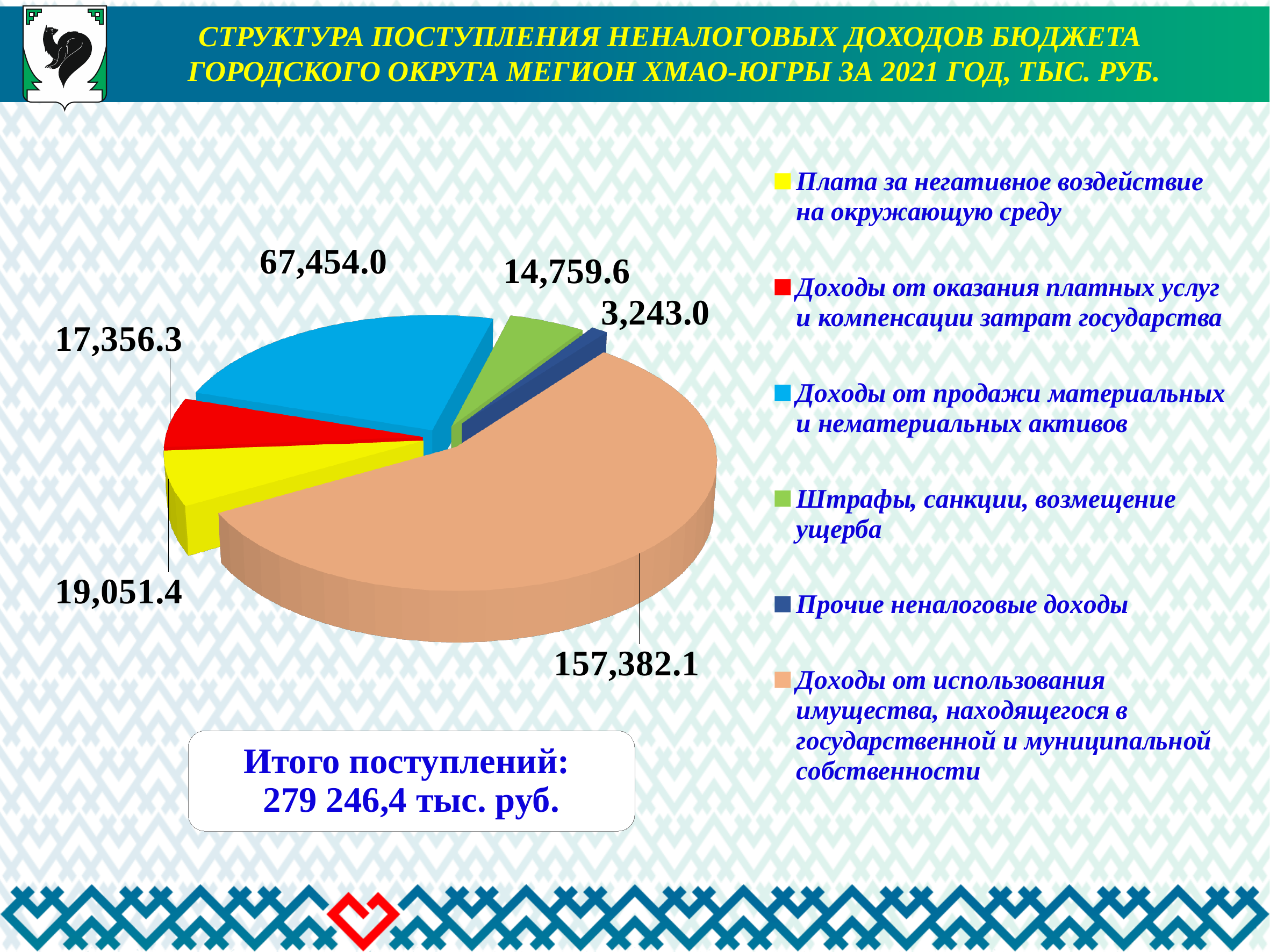
What colour is the slice for «Доходы от оказания платных услуг и компенсации затрат государства»? Red Which is larger: «Плата за негативное воздействие на окружающую среду» or «Доходы от оказания платных услуг и компенсации затрат государства»? Плата за негативное воздействие на окружающую среду What is the value for «Плата за негативное воздействие на окружающую среду»? 19,051.4 What is the value for «Штрафы, санкции, возмещение ущерба»? 14,759.6 Which category has the largest slice of the pie? Доходы от использования имущества, находящегося в государственной и муниципальной собственности What is the difference between «Доходы от продажи материальных и нематериальных активов» and «Плата за негативное воздействие на окружающую среду»? 48,402.6 Which category has the smallest slice of the pie? Прочие неналоговые доходы What total of receipts is stated on the slide? 279 246,4 тыс. руб. What type of chart is shown on the slide? Pie chart What is the value for «Прочие неналоговые доходы»? 3,243.0 How many slices does the pie chart have? 6 What is the value for «Доходы от продажи материальных и нематериальных активов»? 67,454.0